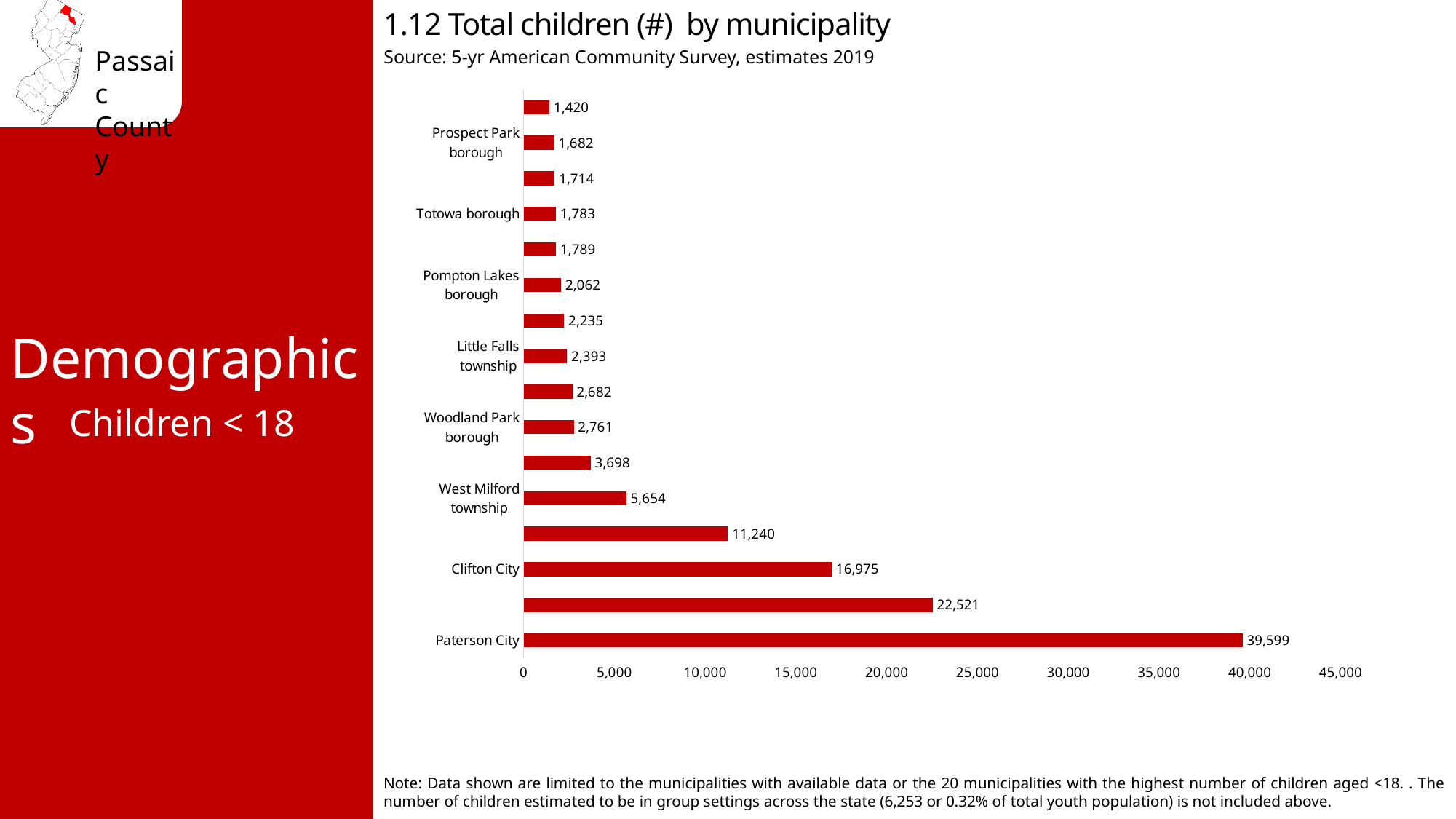
Which has more children, Clifton City or West Milford township? Clifton City What is the difference in total children between Paterson City and Clifton City? 22,624 Which municipality has the highest number of children? Paterson City What is the total number of children for West Milford township? 5,654 What is the total number of children for Paterson City? 39,599 Is the value for Clifton City greater or less than 15,000? greater What type of chart is shown on the slide? Bar chart What is the total number of children for Clifton City? 16,975 What is the total number of children for Prospect Park borough? 1,682 How many bars are plotted in the chart? 16 What is the total number of children for Woodland Park borough? 2,761 What is the title of the chart? 1.12 Total children (#) by municipality